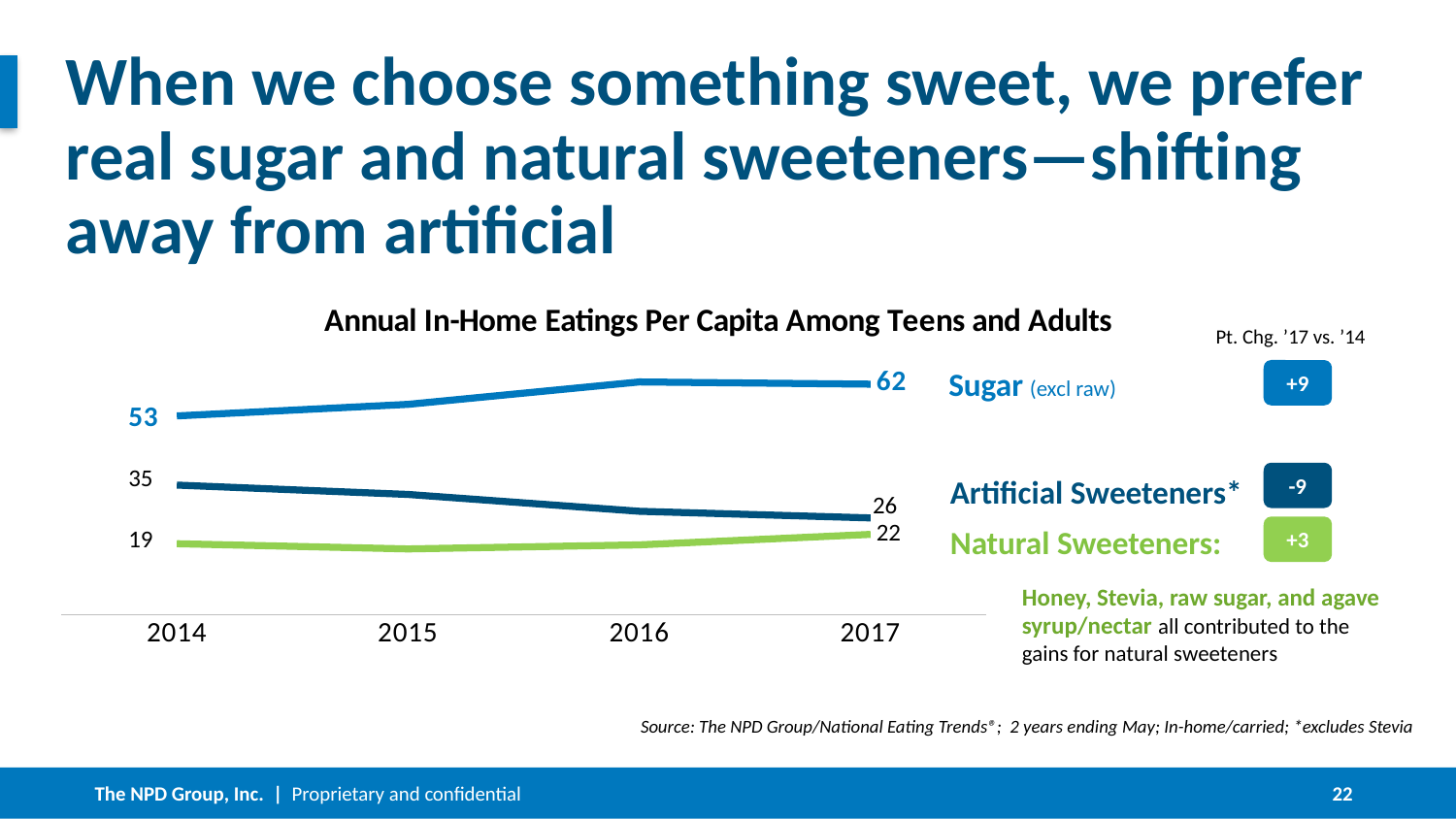
What is the value for Sugar (excl raw) in 2014? 53 What type of chart is shown on the slide? line chart What is the value for Natural Sweeteners in 2017? 22 What is the value for Artificial Sweeteners in 2014? 35 How many series are plotted on the chart? 3 What is the value for Sugar (excl raw) in 2017? 62 Which series has the lowest value in 2014? Natural Sweeteners Which series has the highest value in 2017? Sugar (excl raw) Does the Artificial Sweeteners line rise or fall from 2014 to 2017? fall How many years are shown on the x axis? 4 What is the title of the chart? Annual In-Home Eatings Per Capita Among Teens and Adults What is the difference between the Artificial Sweeteners value in 2014 and in 2017? 9